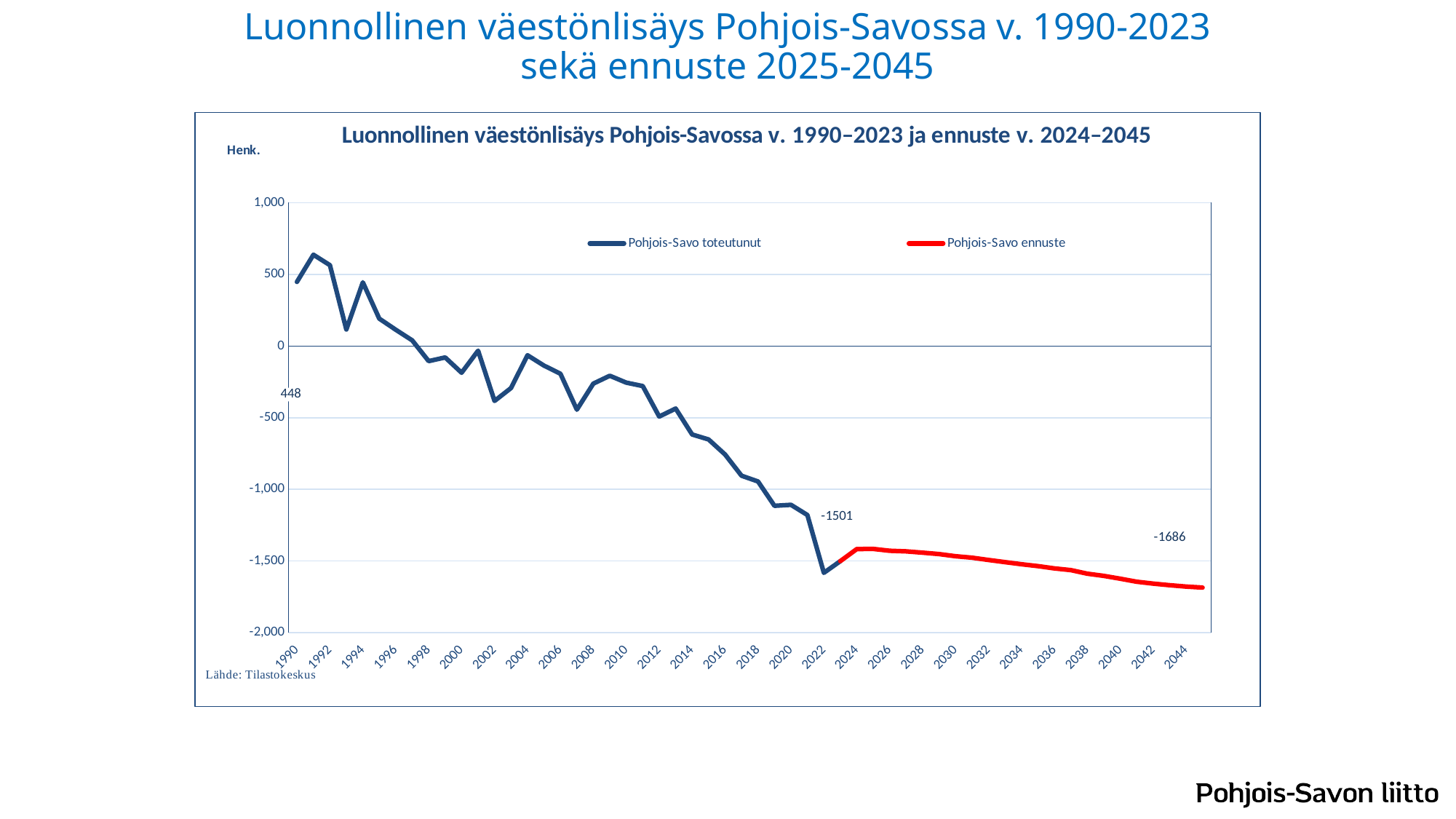
What are the two series named in the legend? Pohjois-Savo toteutunut and Pohjois-Savo ennuste Is the value for 2000 greater or less than 0? less Which year has a higher value, 1993 or 1994? 1994 Which colour is used for the Pohjois-Savo ennuste (forecast) series? red How many series does the legend list? 2 What is the labelled value for 1990? 448 What is the labelled value at the end of the forecast series (2045)? -1686 Is the value for 2016 greater or less than -500? less Is the value for 2010 greater or less than -500? greater What kind of chart is shown on the slide? line chart Do the values generally rise or fall from 1990 to 2045? fall What is the difference between the labelled 1990 value (448) and the labelled 2045 forecast value (-1686)? 2134